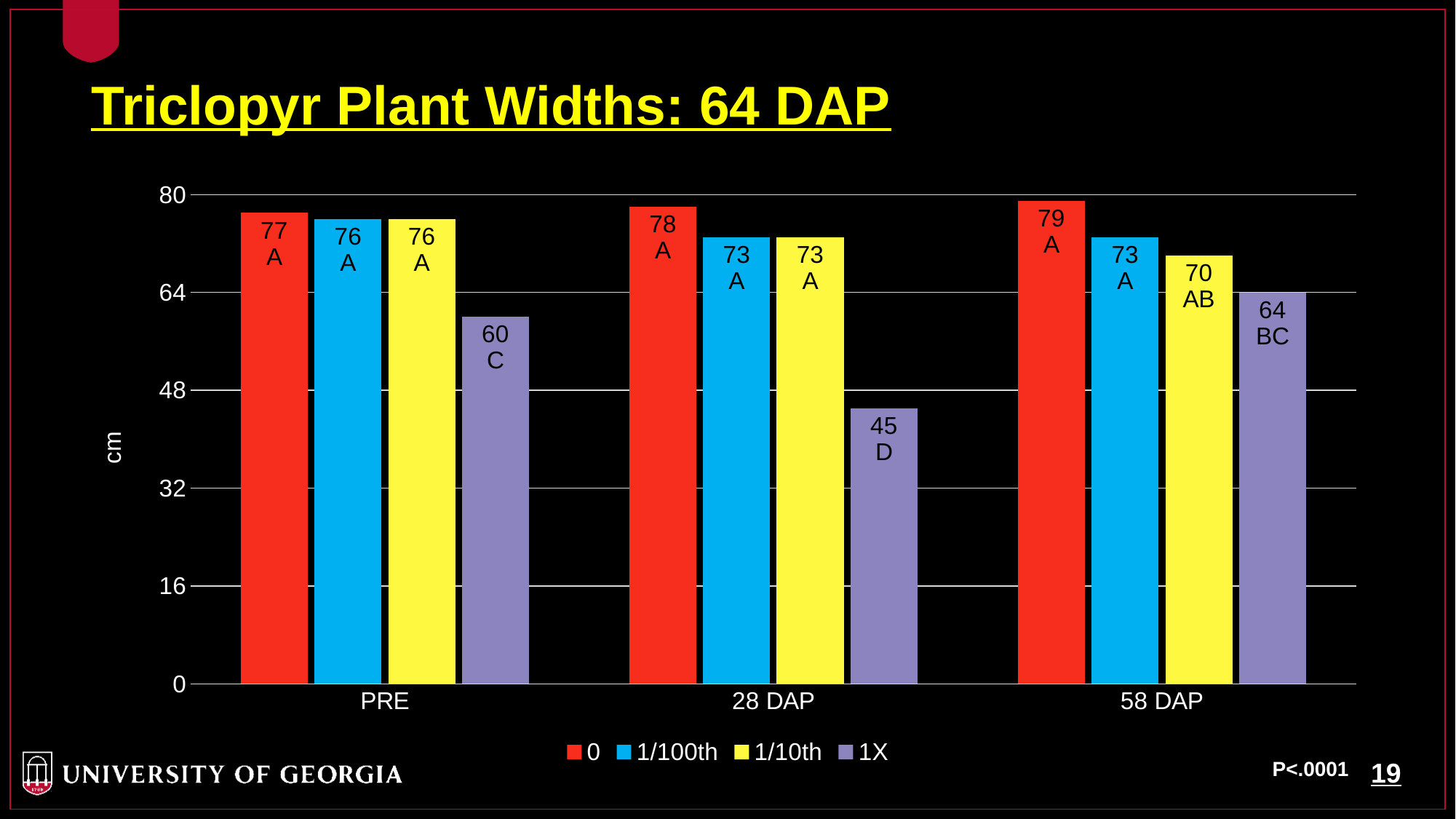
What is the plant width for the 0 series at 58 DAP? 79 What kind of chart is shown on the slide? bar chart Which series has the highest plant width at 28 DAP? 0 What is the difference between the 0 series and the 1X series at 28 DAP? 33 How many categories are shown on the x axis? 3 Is the value for the 1X series at 28 DAP greater or less than 48? less What is the plant width for the 1/10th series at 58 DAP? 70 What is the title of the chart? Triclopyr Plant Widths: 64 DAP Which series has the lowest plant width at PRE? 1X How many series does the legend list? 4 Which is larger: the 1X value at PRE or the 1X value at 58 DAP? 1X at 58 DAP What is the plant width for the 1X series at 28 DAP? 45